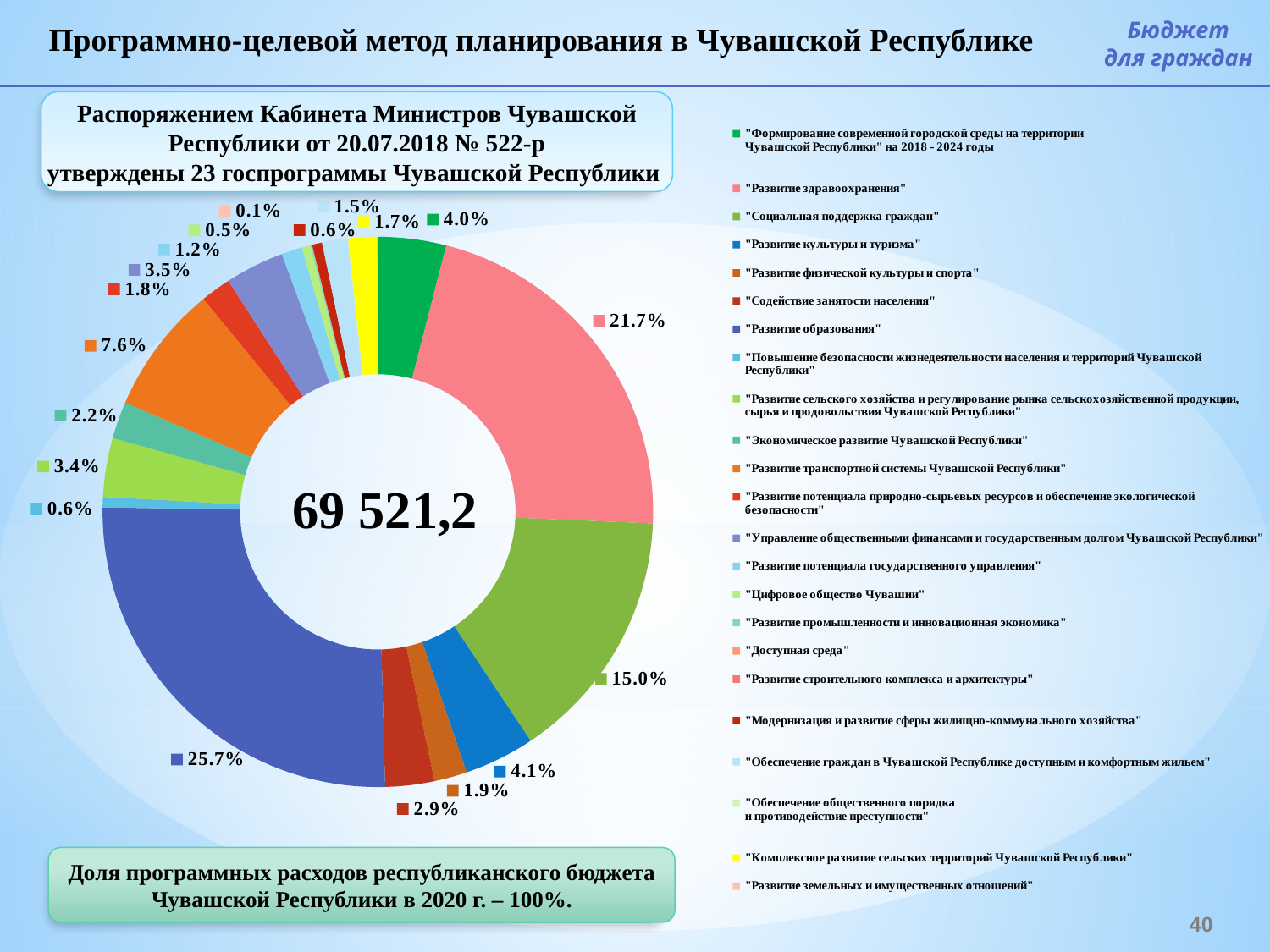
What share does "Управление общественными финансами и государственным долгом Чувашской Республики" have in the chart? 3.5% What share does "Развитие транспортной системы Чувашской Республики" have in the chart? 7.6% Which programme has the largest share in the chart? "Развитие образования" What share does the programme "Развитие образования" have in the chart? 25.7% What share does "Социальная поддержка граждан" have in the chart? 15.0% What share does "Содействие занятости населения" have in the chart? 2.9% What share does the programme "Развитие здравоохранения" have in the chart? 21.7% Which has the larger share: "Развитие транспортной системы Чувашской Республики" or "Развитие сельского хозяйства и регулирование рынка сельскохозяйственной продукции"? "Развитие транспортной системы Чувашской Республики" What kind of chart is shown on the slide? Doughnut (pie) chart What value is printed in the centre of the doughnut chart? 69 521,2 How many programmes (categories) does the chart legend list? 23 By how many percentage points does the share of "Развитие образования" exceed that of "Развитие здравоохранения"? 4.0 percentage points